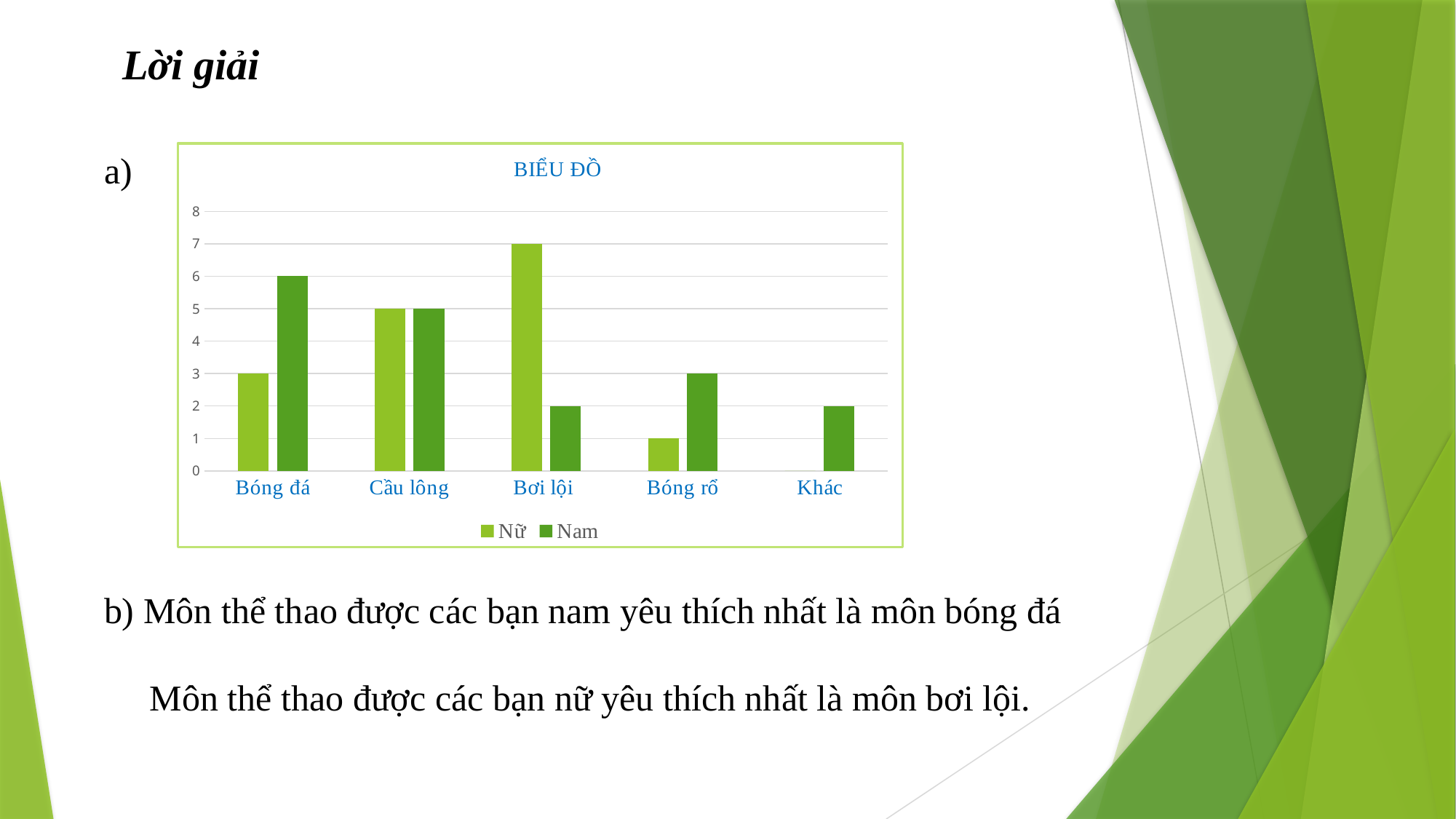
What is the value for Nam in the Khác category? 2 What is the title of the chart? BIỂU ĐỒ Which category has the lowest value for Nam? Bơi lội and Khác Which category has the highest value for Nữ? Bơi lội Is the value for Nữ in the Cầu lông category greater or less than 4? greater Which is larger in the Bóng rổ category, the Nữ value or the Nam value? Nam What is the difference between the Nữ and Nam values in the Bóng đá category? 3 What type of chart is shown on the slide? bar chart What is the value for Nữ in the Bơi lội category? 7 What is the value for Nam in the Bóng đá category? 6 How many series does the legend list? 2 How many categories are shown on the x axis? 5